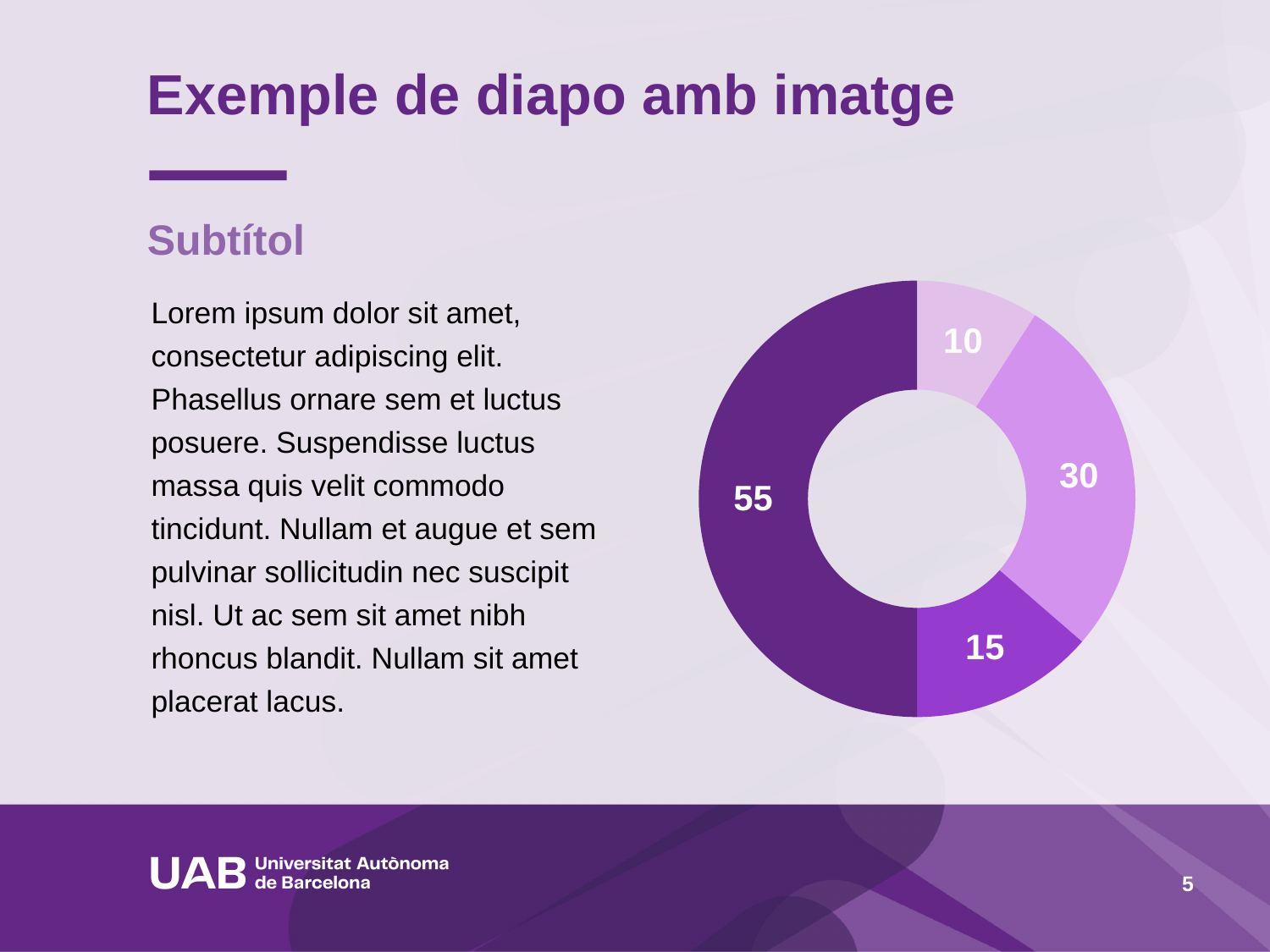
What is the difference between the largest slice (55) and the second-largest slice (30) in the doughnut chart? 25 What value is shown on the lightest (palest) slice of the doughnut chart? 10 What is the largest value shown in the doughnut chart? 55 How many slices does the doughnut chart have? 4 What is the difference between the slices labelled 15 and 10 in the doughnut chart? 5 What share of the doughnut chart's total does the slice labelled 55 represent? 50% What is the smallest value shown in the doughnut chart? 10 What value is shown on the darkest purple slice of the doughnut chart? 55 What kind of chart is shown on the slide? Doughnut chart What is the total of all the values shown in the doughnut chart? 110 Which is larger in the doughnut chart: the slice labelled 30 or the slice labelled 15? 30 Does the doughnut chart on the slide include a legend? No